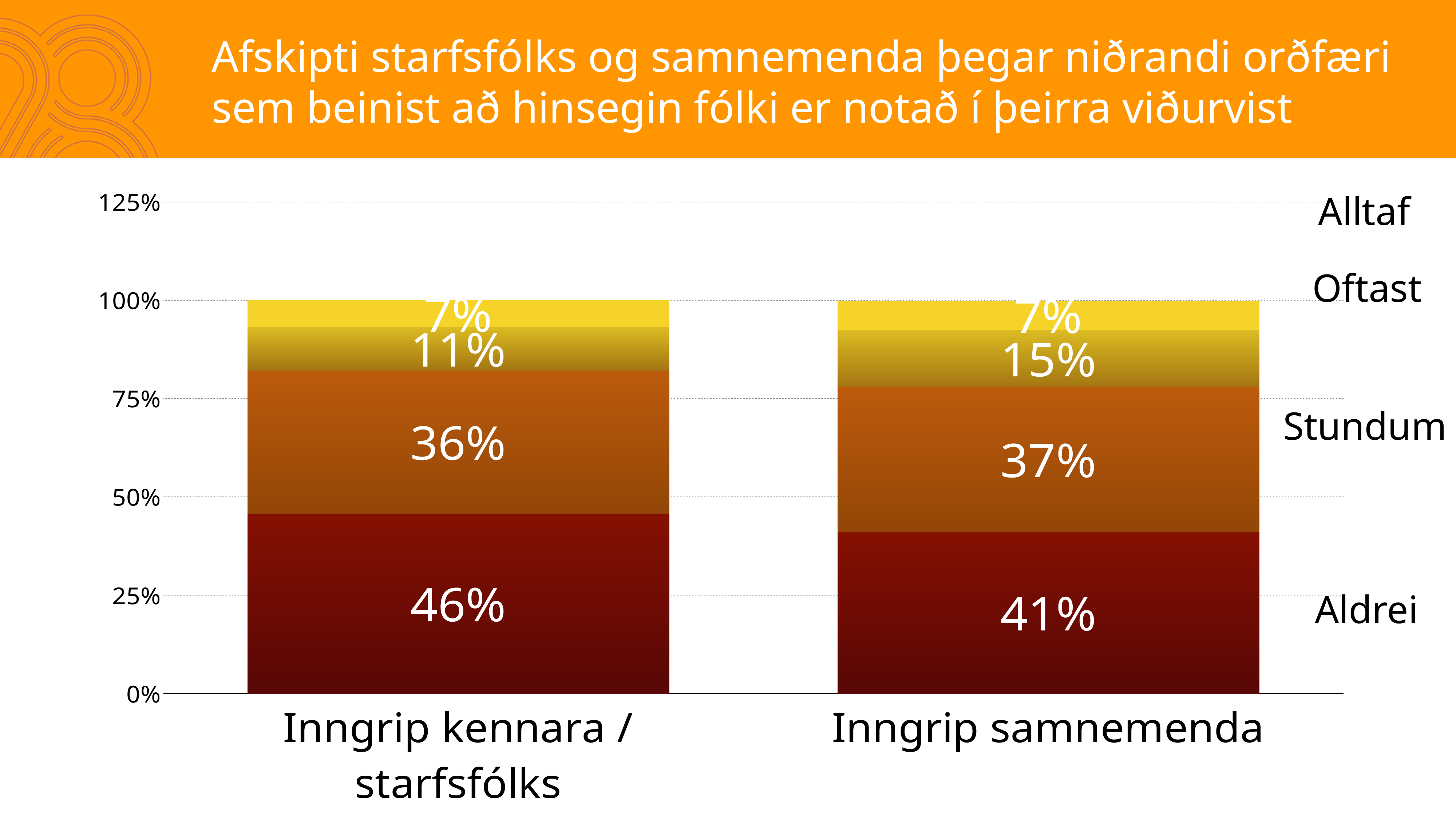
What is the total of the stacked bar for Inngrip kennara / starfsfólks? 100% What is the Oftast value for Inngrip kennara / starfsfólks? 11% What is the Aldrei value for Inngrip samnemenda? 41% What is the Stundum value for Inngrip samnemenda? 37% What kind of chart is shown on the slide? Stacked bar chart Which segment is the largest in the Inngrip samnemenda bar? Aldrei What is the Alltaf value for Inngrip samnemenda? 7% What is the Aldrei value for Inngrip kennara / starfsfólks? 46% What is the difference between the Oftast values for Inngrip samnemenda and Inngrip kennara / starfsfólks? 4% How many categories are shown on the x axis? 2 Which category has the higher Aldrei value? Inngrip kennara / starfsfólks How many series does the legend list? 4